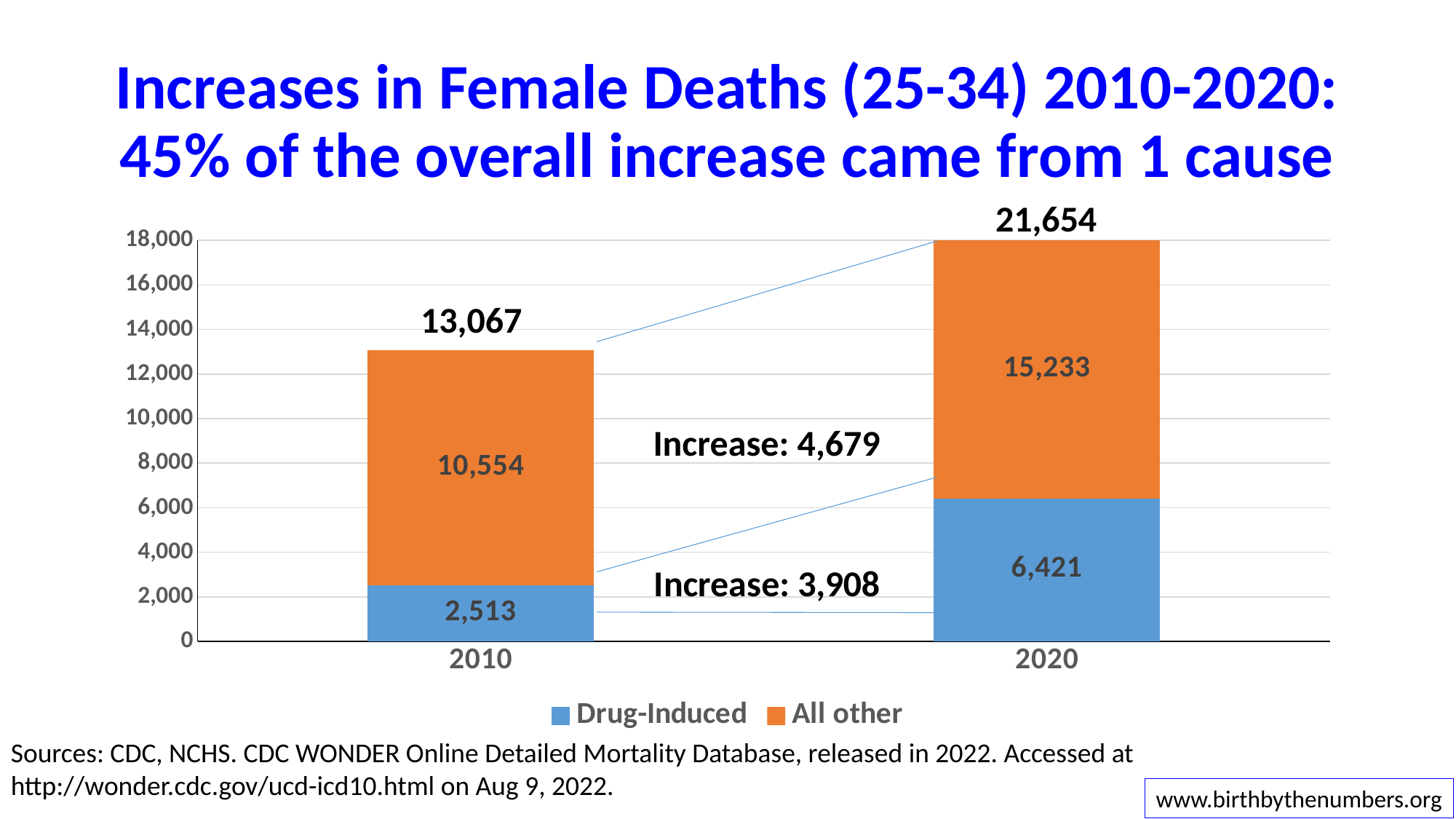
What is the total of the stacked bar for 2010? 13,067 What kind of chart is shown on the slide? Stacked bar chart What is the Drug-Induced value for 2010? 2,513 What is the All other value for 2010? 10,554 What is the Drug-Induced value for 2020? 6,421 What is the All other value for 2020? 15,233 Which year has the larger Drug-Induced value, 2010 or 2020? 2020 What is the difference between the Drug-Induced values for 2020 and 2010? 3,908 What is the total of the stacked bar for 2020? 21,654 Which colour represents the All other series? Orange What is the difference between the All other values for 2020 and 2010? 4,679 How many series does the legend list? 2